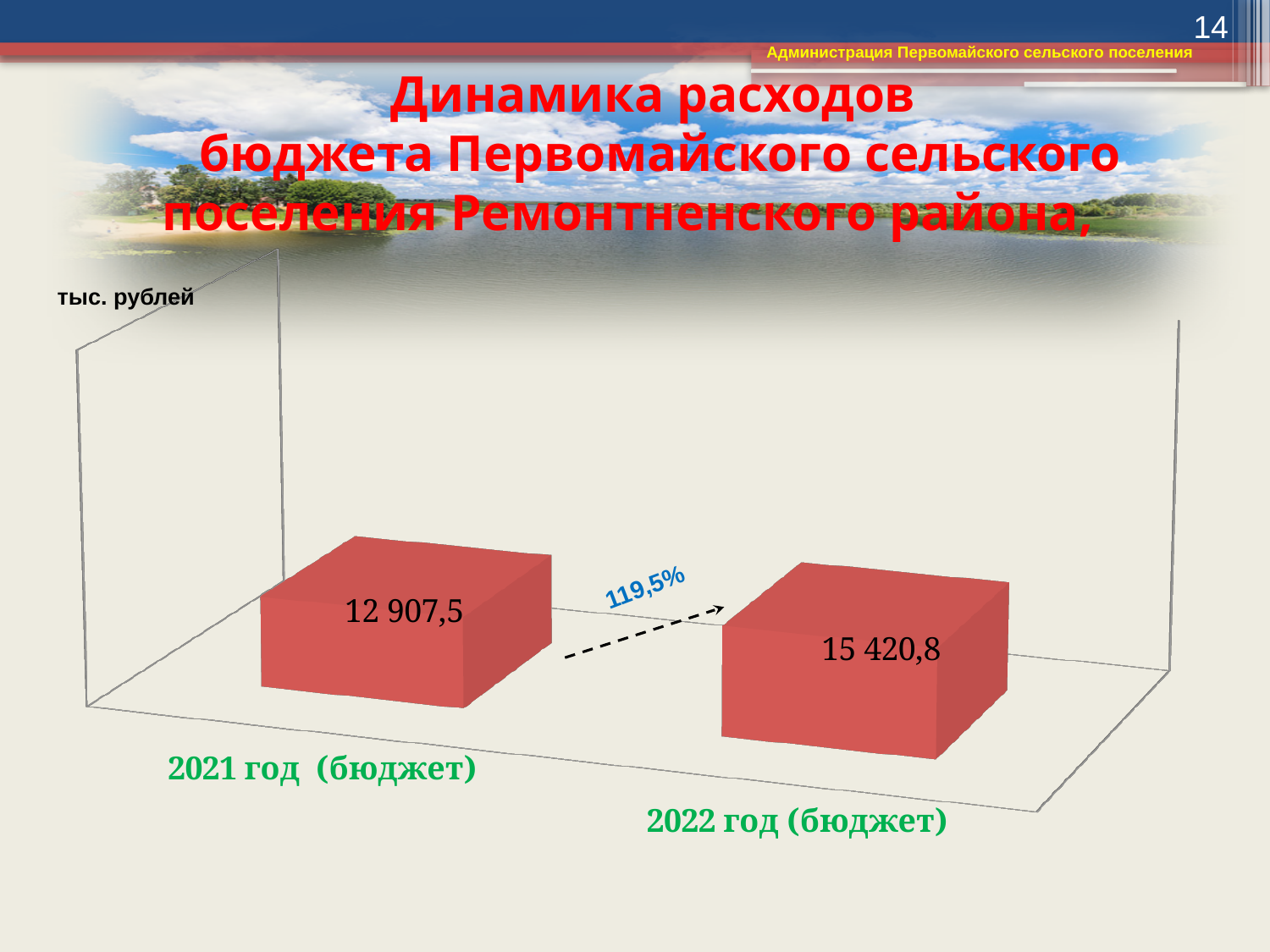
What unit of measurement is indicated on the chart? тыс. рублей What is the value for 2021 год (бюджет)? 12 907,5 What is the value for 2022 год (бюджет)? 15 420,8 What percentage is shown on the arrow between the two bars? 119,5% Which category has the lowest value? 2021 год (бюджет) How many categories are shown in the chart? 2 Which category has the highest value? 2022 год (бюджет) Which is larger: the value for 2021 год (бюджет) or the value for 2022 год (бюджет)? 2022 год (бюджет) What kind of chart is shown on the slide? Bar chart What is the difference between the values for 2022 год (бюджет) and 2021 год (бюджет)? 2 513,3 Do the values rise or fall from 2021 год (бюджет) to 2022 год (бюджет)? Rise